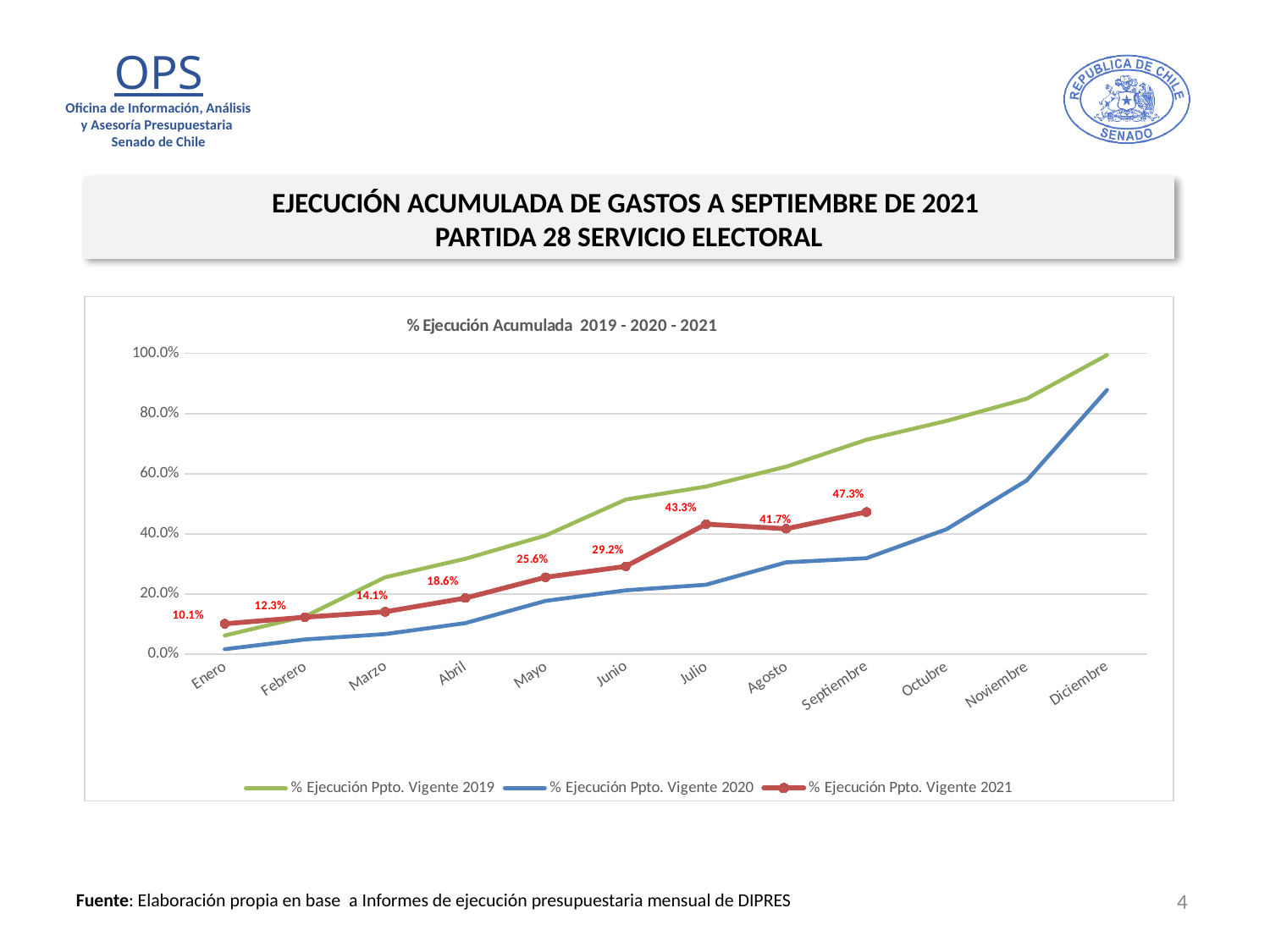
Which month has the highest value in the % Ejecución Ppto. Vigente 2021 series? Septiembre What is the value for Julio in the % Ejecución Ppto. Vigente 2021 series? 43.3% How many series does the legend list? 3 What is the difference between the Septiembre and Agosto values in the % Ejecución Ppto. Vigente 2021 series? 5.6% Is the value for Septiembre in the % Ejecución Ppto. Vigente 2019 series greater or less than 60.0%? greater In the % Ejecución Ppto. Vigente 2021 series, which is larger, the value for Julio or the value for Agosto? Julio Does the % Ejecución Ppto. Vigente 2019 series rise or fall from Enero to Diciembre? Rise Is the value for Diciembre in the % Ejecución Ppto. Vigente 2020 series greater or less than 80.0%? greater Which month has the lowest value in the % Ejecución Ppto. Vigente 2021 series? Enero What is the value for Enero in the % Ejecución Ppto. Vigente 2021 series? 10.1% What is the value for Septiembre in the % Ejecución Ppto. Vigente 2021 series? 47.3% What kind of chart is shown on the slide? Line chart